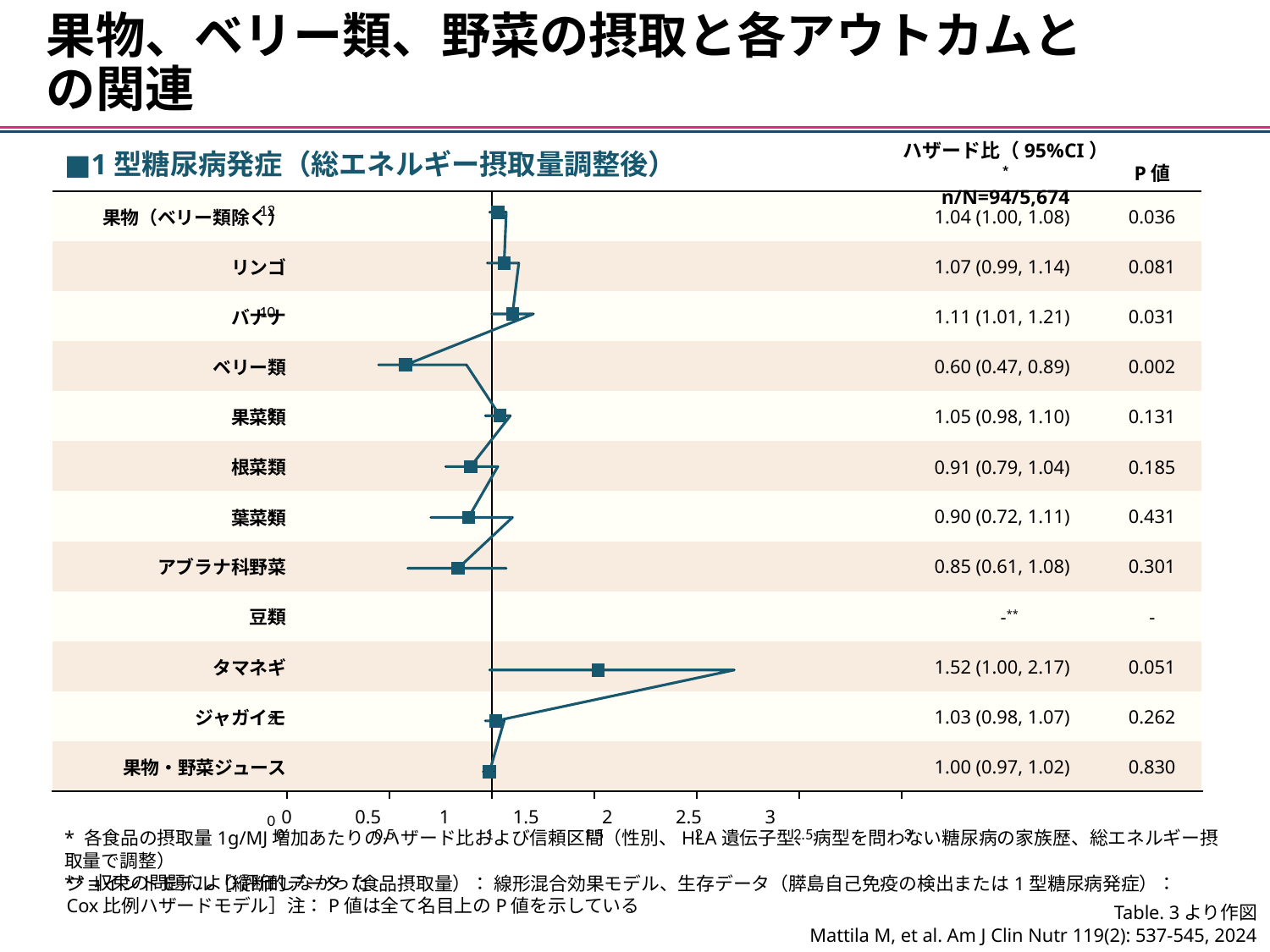
Which food category has the lowest hazard ratio? ベリー類 What is the hazard ratio (95% CI) for タマネギ? 1.52 (1.00, 2.17) Is the hazard ratio for アブラナ科野菜 greater or less than 1? less What is the difference between the hazard ratio for タマネギ and the hazard ratio for ベリー類? 0.92 What is the P value for バナナ? 0.031 Which food category has the highest hazard ratio? タマネギ What is the hazard ratio (95% CI) for 果物・野菜ジュース? 1.00 (0.97, 1.02) What n/N value is shown in the hazard ratio column header? n/N=94/5,674 What kind of chart is shown on the slide? forest plot What is the hazard ratio (95% CI) for ベリー類? 0.60 (0.47, 0.89) Which has the larger hazard ratio, バナナ or リンゴ? バナナ How many food categories are listed in the chart? 12